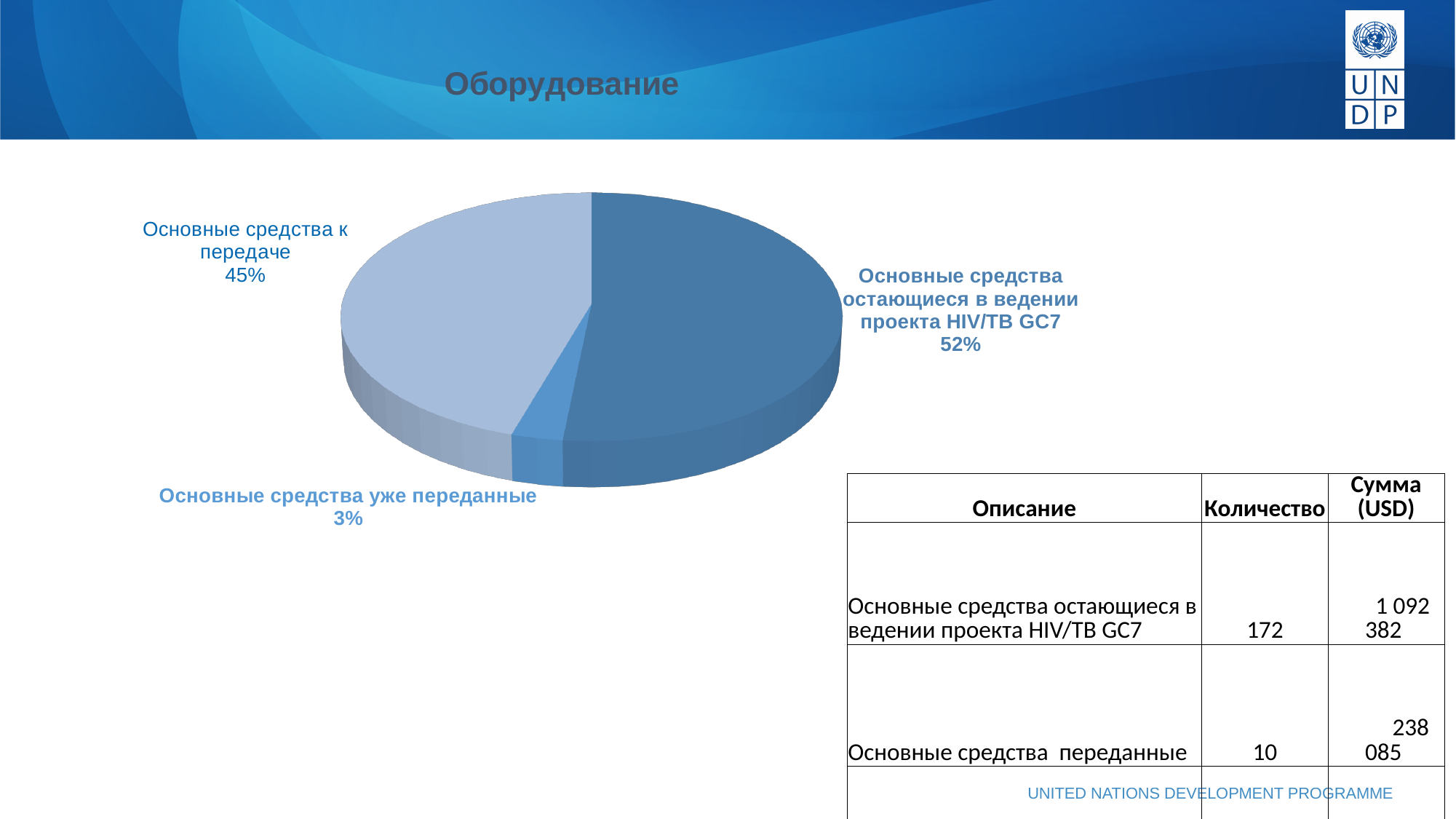
What share of the pie does "Основные средства остающиеся в ведении проекта HIV/TB GC7" have? 52% What share of the pie does "Основные средства к передаче" have? 45% Which is larger: the share for "Основные средства к передаче" or the share for "Основные средства уже переданные"? Основные средства к передаче Is the share for "Основные средства остающиеся в ведении проекта HIV/TB GC7" greater or less than 50%? greater What is the difference in percentage points between "Основные средства остающиеся в ведении проекта HIV/TB GC7" and "Основные средства к передаче"? 7 percentage points What is the difference in percentage points between "Основные средства к передаче" and "Основные средства уже переданные"? 42 percentage points How many slices does the pie chart have? 3 Which slice of the pie chart is the largest? Основные средства остающиеся в ведении проекта HIV/TB GC7 Which slice of the pie chart is the smallest? Основные средства уже переданные What kind of chart is shown on the slide? Pie chart What is the title of the slide containing the pie chart? Оборудование What share of the pie does "Основные средства уже переданные" have? 3%